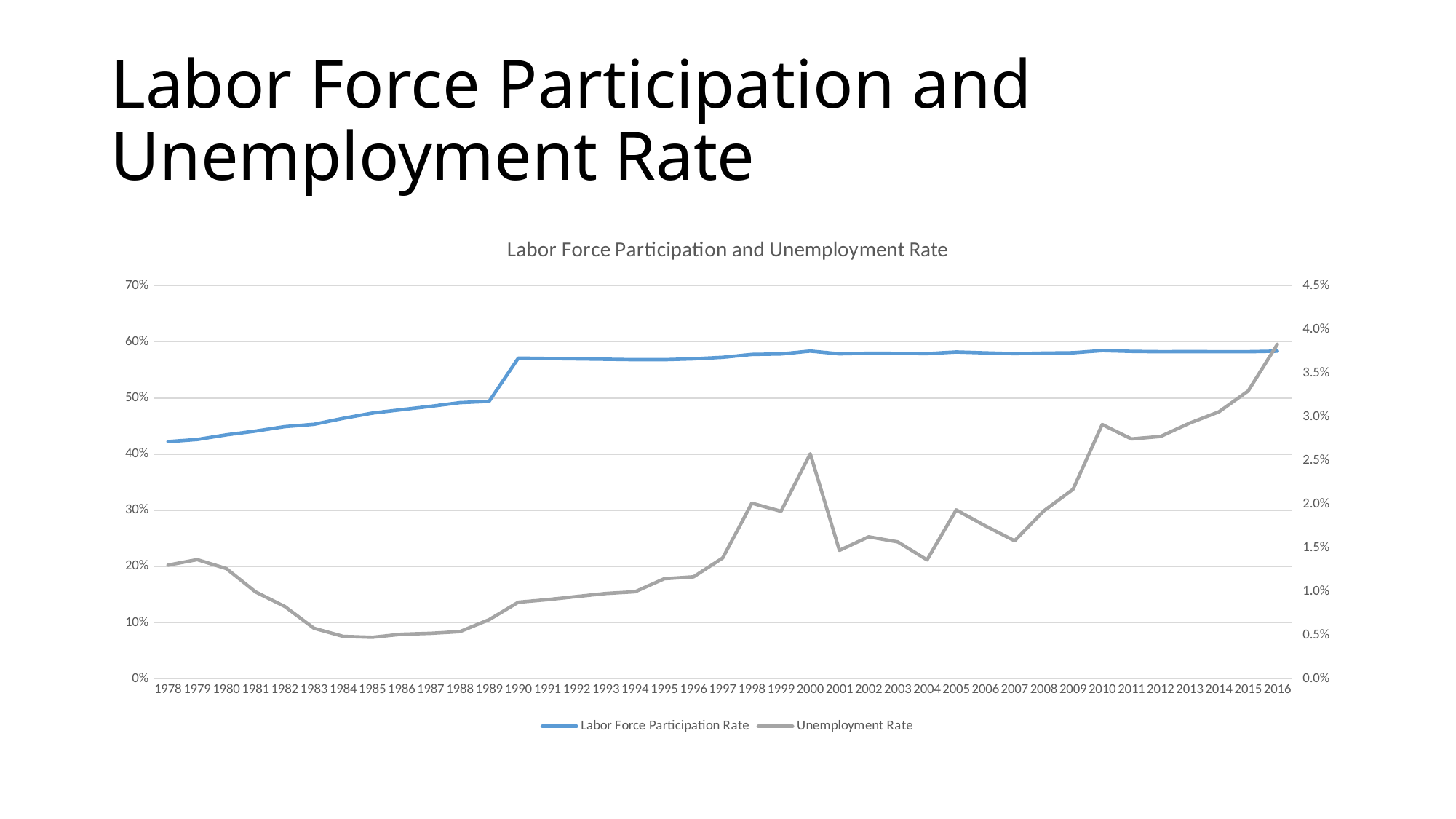
What is the title of the chart? Labor Force Participation and Unemployment Rate Is the Labor Force Participation Rate in 1990 greater or less than 50%? greater Does the Labor Force Participation Rate generally rise or fall from 1978 to 2016? Rise Which series is drawn in blue? Labor Force Participation Rate How many series does the legend list? 2 Is the Unemployment Rate in 2000 greater or less than 2.0%? greater How many years are plotted along the x axis? 39 What kind of chart is shown on the slide? Line chart In which year is the Unemployment Rate highest? 2016 Is the Unemployment Rate in 1985 greater or less than 1.0%? less Which year has the higher Unemployment Rate, 1979 or 1983? 1979